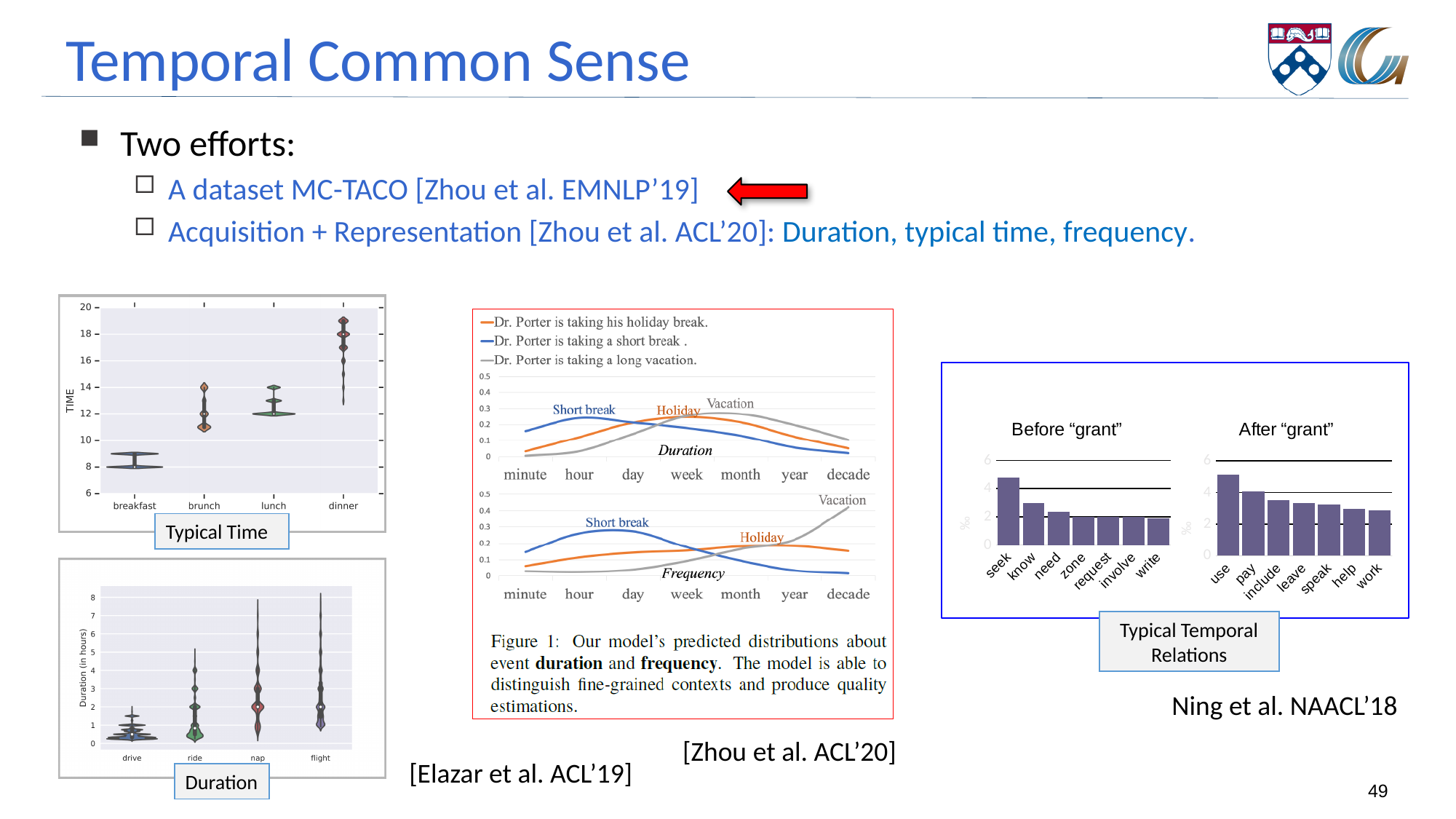
In the 'After "grant"' chart, is the value for 'use' greater or less than 4? greater In the Figure 1 Duration chart, at which x-axis unit does the 'Short break' curve peak? hour What kind of chart is the 'Before "grant"' chart? bar chart In the 'Typical Time' chart, which meal has the highest typical time values? dinner In the 'Before "grant"' chart, which word has the tallest bar? seek In the 'Typical Time' chart, which meal has the lowest typical time values? breakfast In the 'Typical Time' chart, how many meal categories are shown on the x axis? 4 In the 'Duration' chart, what are the four activity categories on the x axis? drive, ride, nap, flight In the Figure 1 line charts, how many time units are shown on the x axis? 7 In the Figure 1 line charts, how many sentences does the legend list? 3 In the 'Duration' chart, what is the label of the y axis? Duration (in hours)